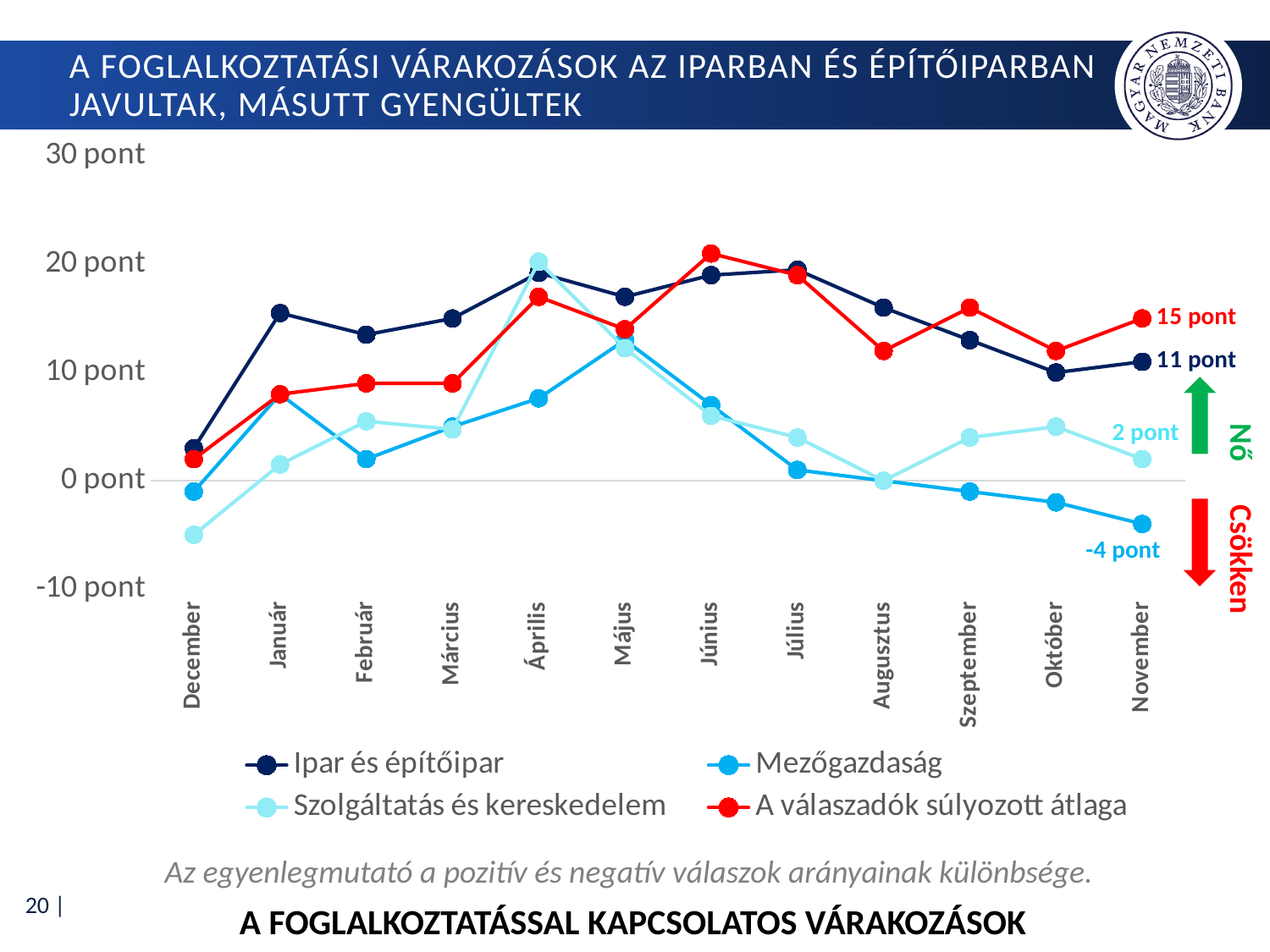
What is the November value for the series 'A válaszadók súlyozott átlaga'? 15 pont What is the November value for 'Mezőgazdaság'? -4 pont How many series does the legend list? 4 Does the 'Mezőgazdaság' series rise or fall from Június to November? falls How many months are shown on the x axis? 12 In November, what is the difference between 'A válaszadók súlyozott átlaga' and 'Ipar és építőipar'? 4 pont What kind of chart is shown on the slide? line chart Which series has the lowest value in November? Mezőgazdaság What is the November value for 'Szolgáltatás és kereskedelem'? 2 pont Which series has the highest value in November? A válaszadók súlyozott átlaga What is the November value for 'Ipar és építőipar'? 11 pont Is the value for 'Ipar és építőipar' in Április greater or less than 10 pont? greater